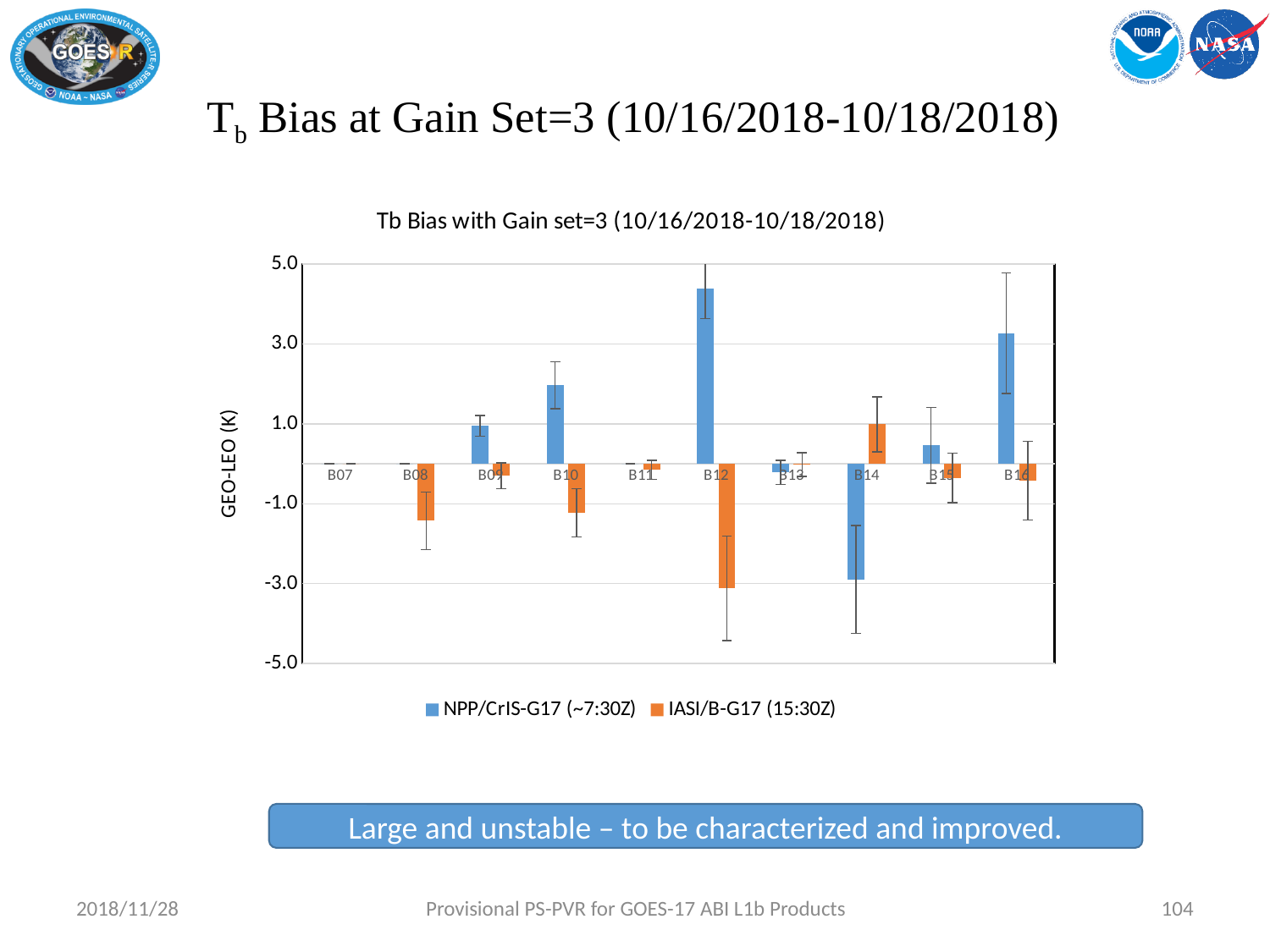
Is the NPP/CrIS-G17 (~7:30Z) value for B10 greater or less than 1.0? greater What kind of chart is shown on the slide? bar chart Is the IASI/B-G17 (15:30Z) value for B12 greater or less than -1.0? less For which band is the IASI/B-G17 (15:30Z) bias lowest? B12 What is the title of the chart? Tb Bias with Gain set=3 (10/16/2018-10/18/2018) For which band is the NPP/CrIS-G17 (~7:30Z) bias highest? B12 What is the label on the y axis? GEO-LEO (K) Which is larger, the NPP/CrIS-G17 (~7:30Z) value for B12 or for B10? B12 Is the NPP/CrIS-G17 (~7:30Z) value for B12 greater or less than 3.0? greater How many band categories are plotted along the x axis? 10 For which band is the NPP/CrIS-G17 (~7:30Z) bias lowest? B14 How many series does the legend list? 2